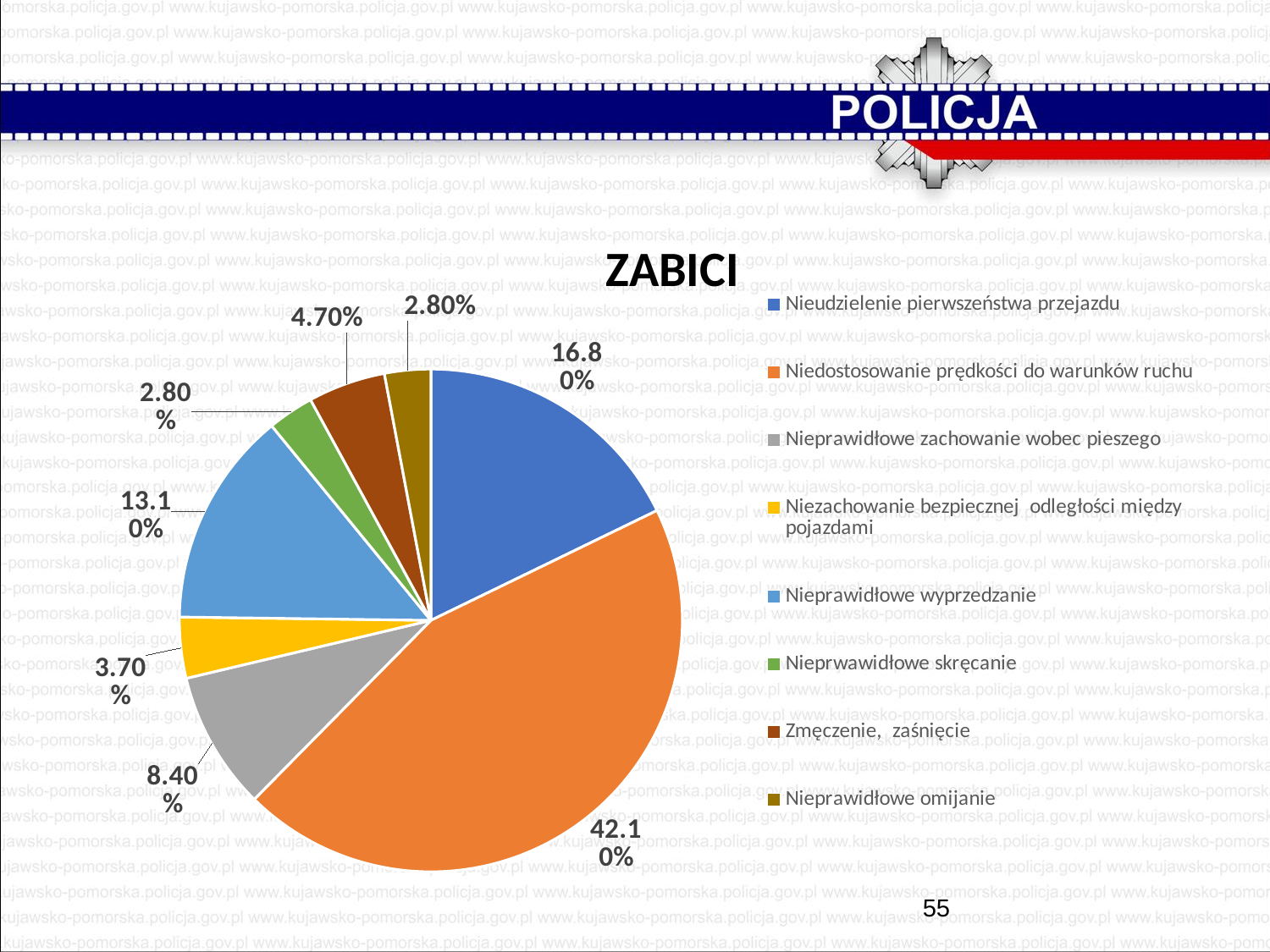
What kind of chart is shown on the slide? pie chart What share of the pie is 'Niezachowanie bezpiecznej odległości między pojazdami'? 3.70% What is the difference in percentage points between 'Niedostosowanie prędkości do warunków ruchu' and 'Nieudzielenie pierwszeństwa przejazdu'? 25.30 What is the title of the chart? ZABICI What share of the pie is 'Nieprawidłowe wyprzedzanie'? 13.10% What share of the pie is 'Niedostosowanie prędkości do warunków ruchu'? 42.10% Which category has the largest share of the pie? Niedostosowanie prędkości do warunków ruchu How many categories does the legend list? 8 What share of the pie is 'Nieprawidłowe zachowanie wobec pieszego'? 8.40% What share of the pie is 'Zmęczenie, zaśnięcie'? 4.70% What share of the pie is 'Nieudzielenie pierwszeństwa przejazdu'? 16.80% Which is larger: the share for 'Nieudzielenie pierwszeństwa przejazdu' or for 'Nieprawidłowe wyprzedzanie'? Nieudzielenie pierwszeństwa przejazdu